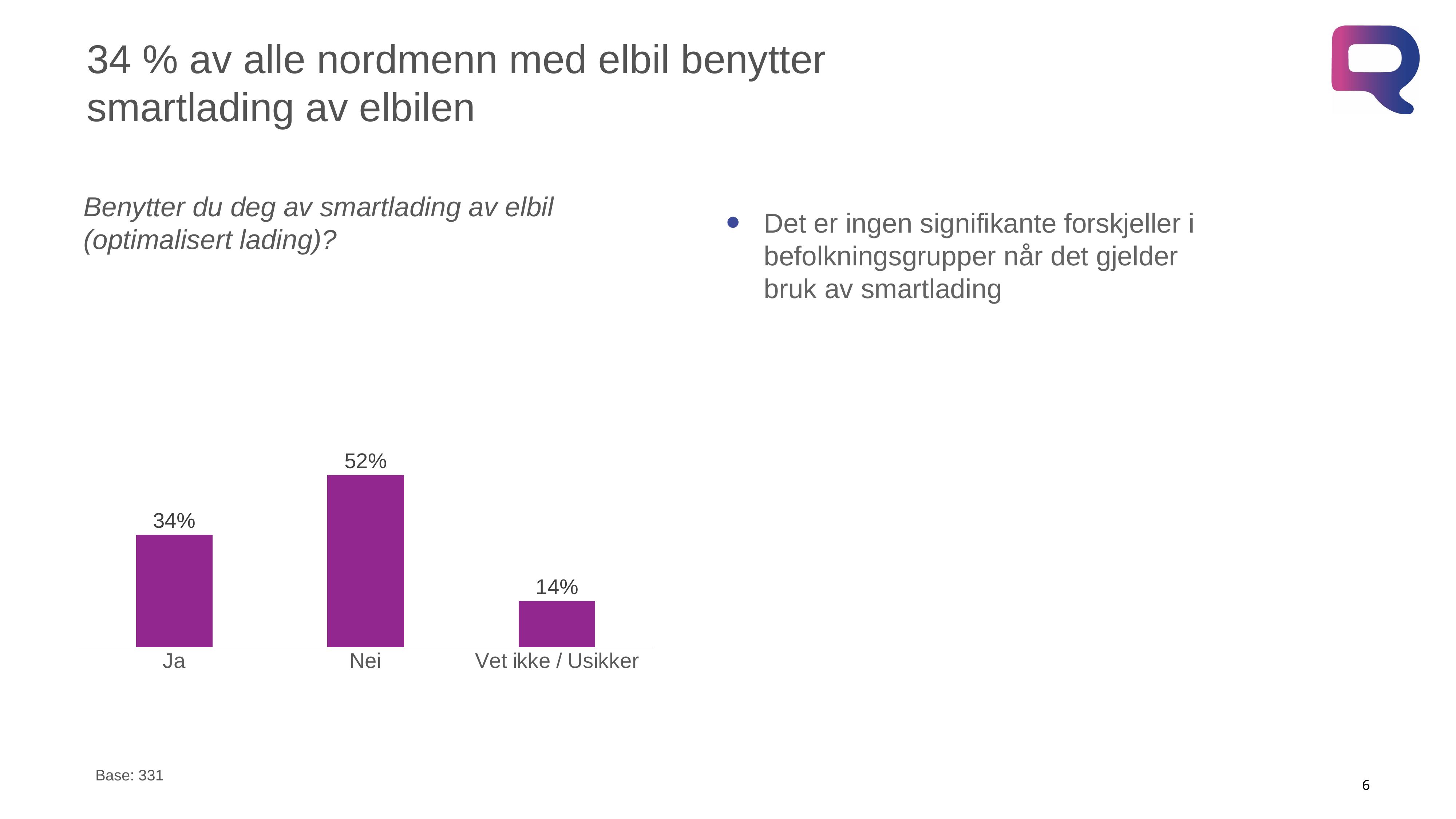
What is the value for Vet ikke / Usikker? 14% What is the difference between the values for Ja and Vet ikke / Usikker? 20% Which category has the lowest value? Vet ikke / Usikker What is the value for Nei? 52% What colour are the bars in the chart? Purple How many categories are shown in the chart? 3 What is the difference between the values for Nei and Ja? 18% What is the value for Ja? 34% What is the base (number of respondents) stated below the chart? 331 What kind of chart is shown on the slide? Bar chart Which is larger, the value for Ja or the value for Nei? Nei Which category has the highest value? Nei